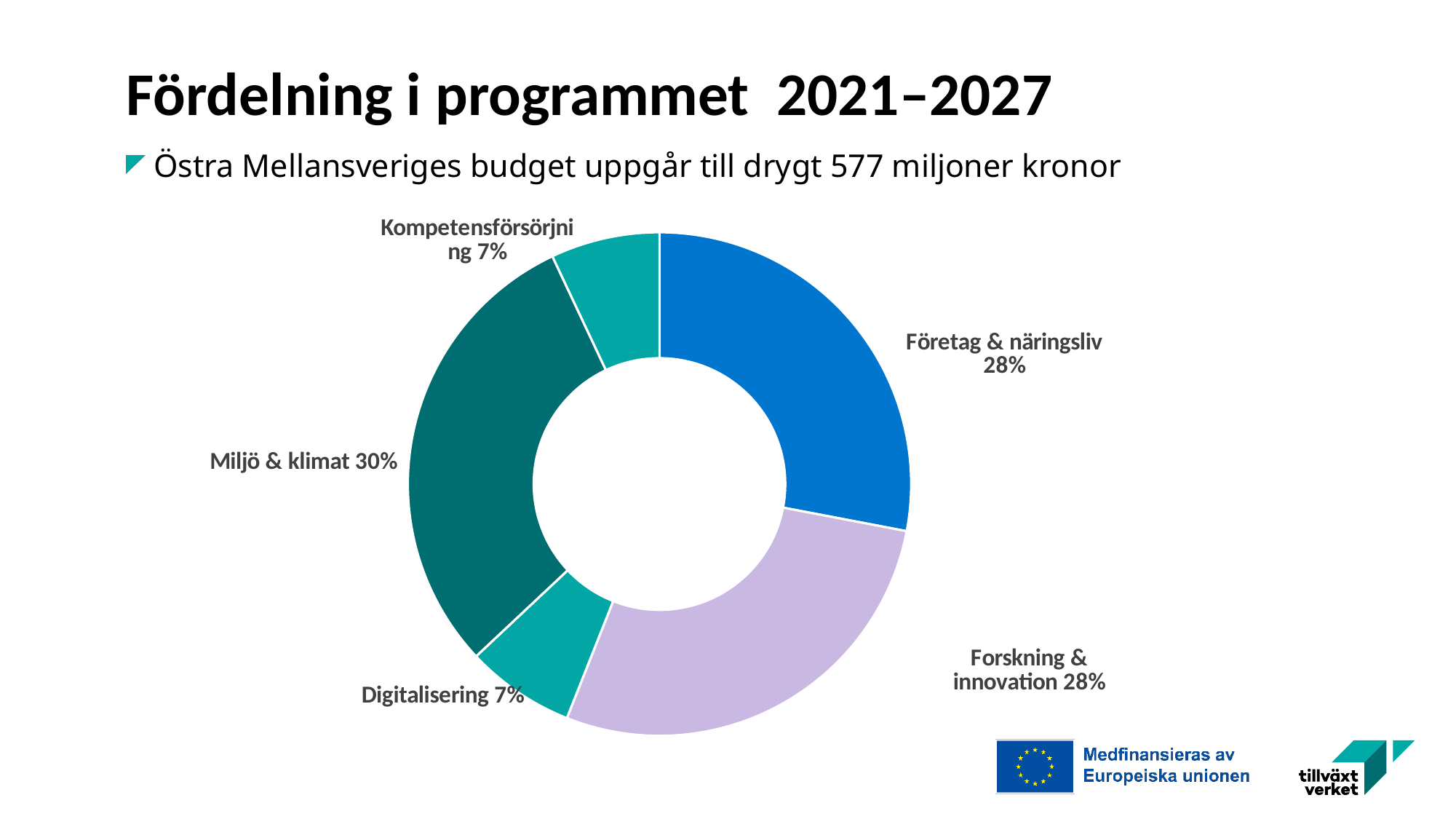
What share of the programme goes to Företag & näringsliv? 28% What share of the programme goes to Forskning & innovation? 28% How many percentage points larger is the share for Miljö & klimat than the share for Digitalisering? 23 Which category has the largest share of the programme? Miljö & klimat What share of the programme goes to Digitalisering? 7% How many categories does the chart show? 5 What share of the programme goes to Miljö & klimat? 30% What kind of chart is shown on the slide? doughnut chart According to the slide, what is the total budget for Östra Mellansverige? drygt 577 miljoner kronor What share of the programme goes to Kompetensförsörjning? 7% Which two categories have the smallest share of the programme? Digitalisering and Kompetensförsörjning Which is larger, the share for Miljö & klimat or the share for Företag & näringsliv? Miljö & klimat